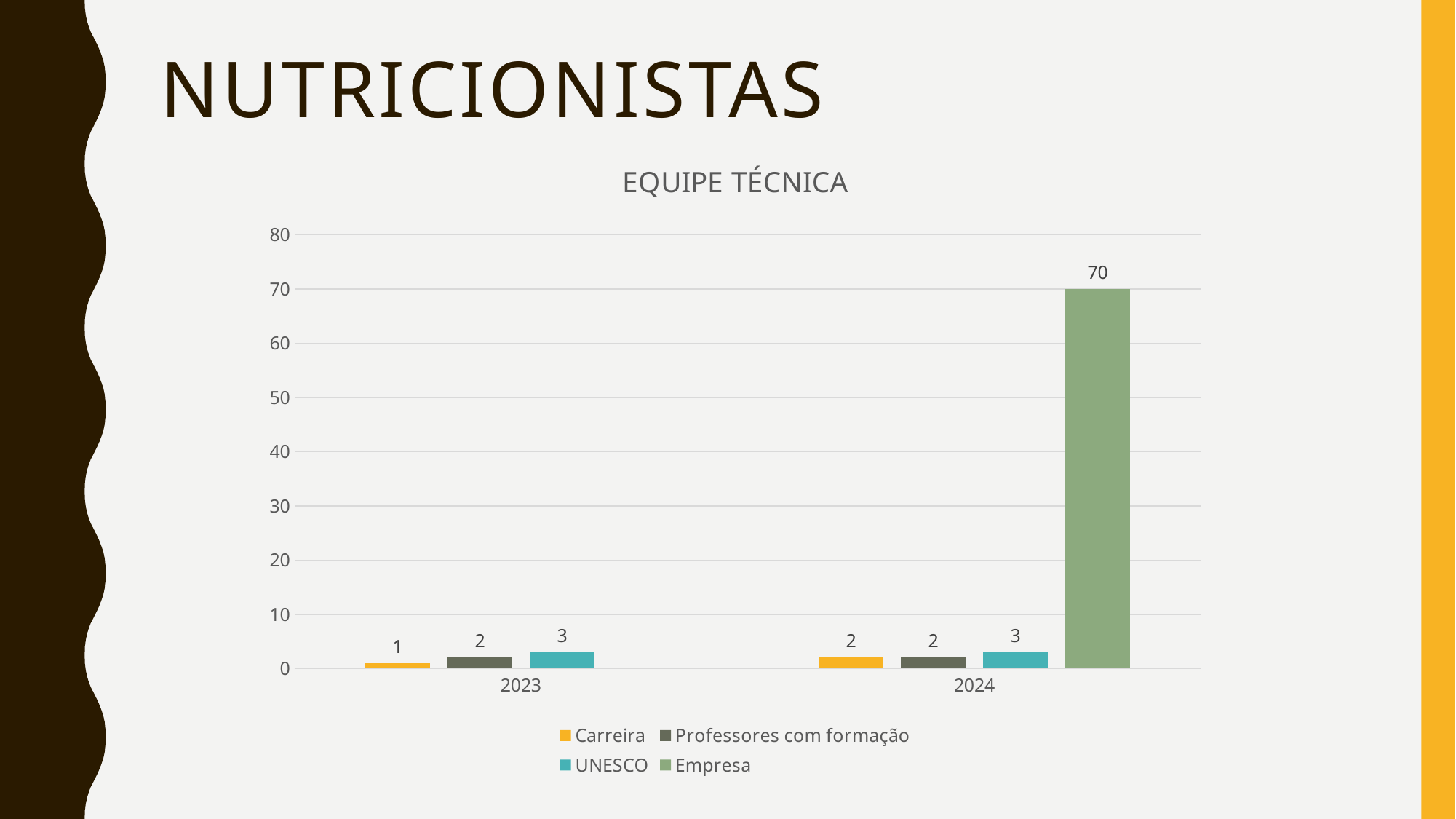
Which series has the highest value in 2024? Empresa What kind of chart is shown on the slide? Bar chart Which series has the lowest value in 2023? Carreira Is the value for Empresa in 2024 greater or less than 60? greater What is the title of the chart? EQUIPE TÉCNICA What is the value for UNESCO in 2024? 3 How many series does the legend list? 4 Which is larger: Carreira in 2023 or Carreira in 2024? Carreira in 2024 What is the value for Empresa in 2024? 70 What is the value for Carreira in 2023? 1 What is the difference between the Empresa value in 2024 and the UNESCO value in 2024? 67 What is the value for Professores com formação in 2023? 2